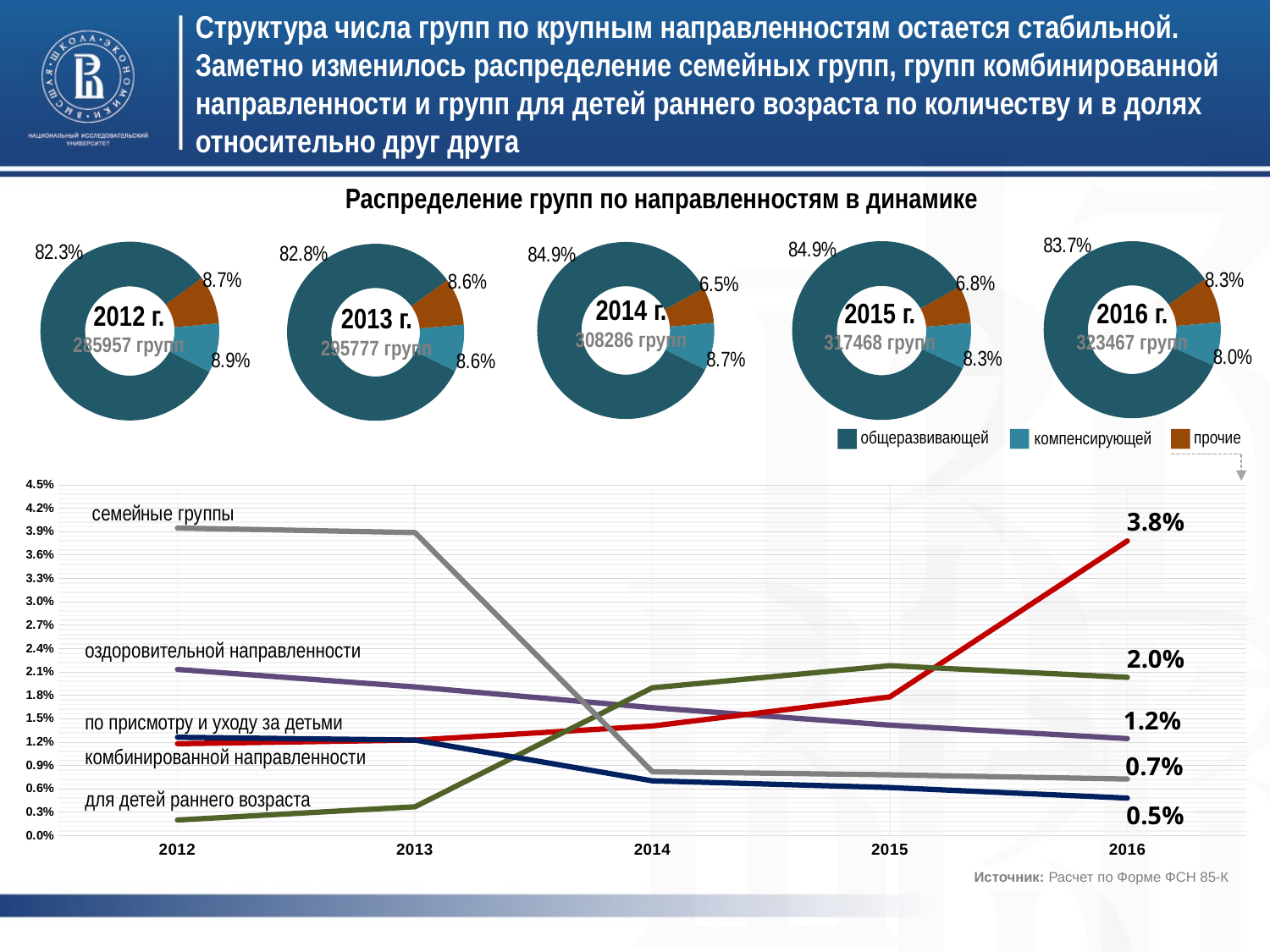
In the 2016 donut chart, how many groups in total are shown in the centre? 323467 групп What kind of chart is the chart at the bottom of the slide? line chart Comparing the 2012 and 2016 donut charts, which year has the larger share of общеразвивающей groups? 2016 In the line chart at the bottom, what value is labelled for комбинированной направленности in 2016? 3.8% In the line chart, is the value for семейные группы in 2012 greater or less than 3.0%? greater In the line chart, what is the difference between the 2016 values for комбинированной направленности and для детей раннего возраста? 1.8% In the 2012 donut chart, what share of groups is общеразвивающей? 82.3% In the line chart, does the series семейные группы rise or fall from 2012 to 2016? fall How many donut charts are shown in the row under the title 'Распределение групп по направленностям в динамике'? 5 In the line chart, which series has the highest value in 2016? комбинированной направленности In the 2014 donut chart, what share is labelled for прочие? 6.5% How many series are plotted in the line chart at the bottom of the slide? 5